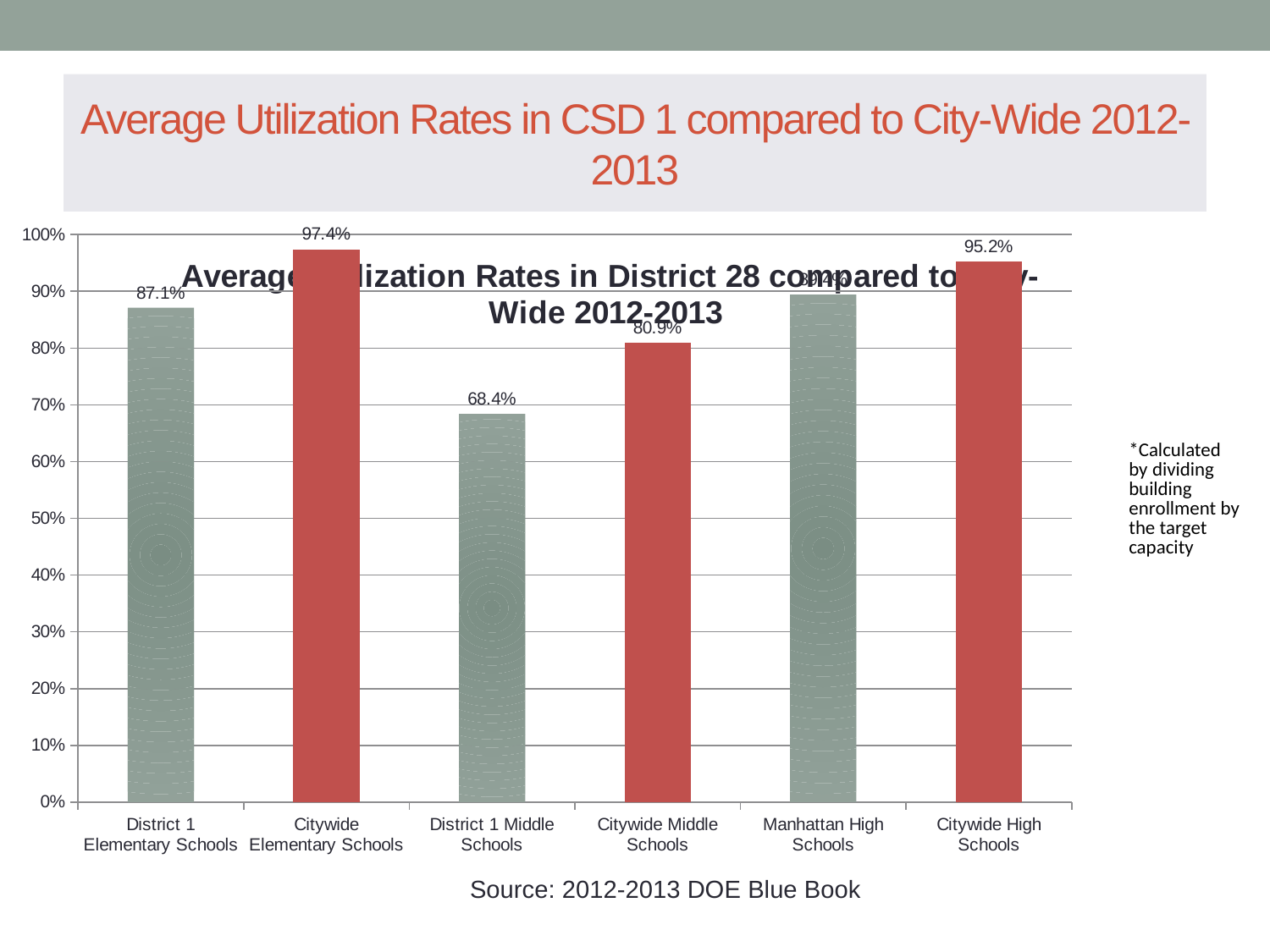
How much higher is the utilization rate for Citywide Elementary Schools than for District 1 Elementary Schools? 10.3% What is the average utilization rate for District 1 Middle Schools? 68.4% What is the average utilization rate for Citywide Middle Schools? 80.9% What kind of chart is shown on the slide? bar chart What is the average utilization rate for Citywide High Schools? 95.2% How many categories are shown on the x axis of the chart? 6 What is the average utilization rate for District 1 Elementary Schools? 87.1% Which category has the lowest utilization rate? District 1 Middle Schools Which has a higher utilization rate, District 1 Middle Schools or Citywide Middle Schools? Citywide Middle Schools Is the value for Manhattan High Schools greater or less than 80%? greater Which category has the highest utilization rate? Citywide Elementary Schools What is the average utilization rate for Citywide Elementary Schools? 97.4%